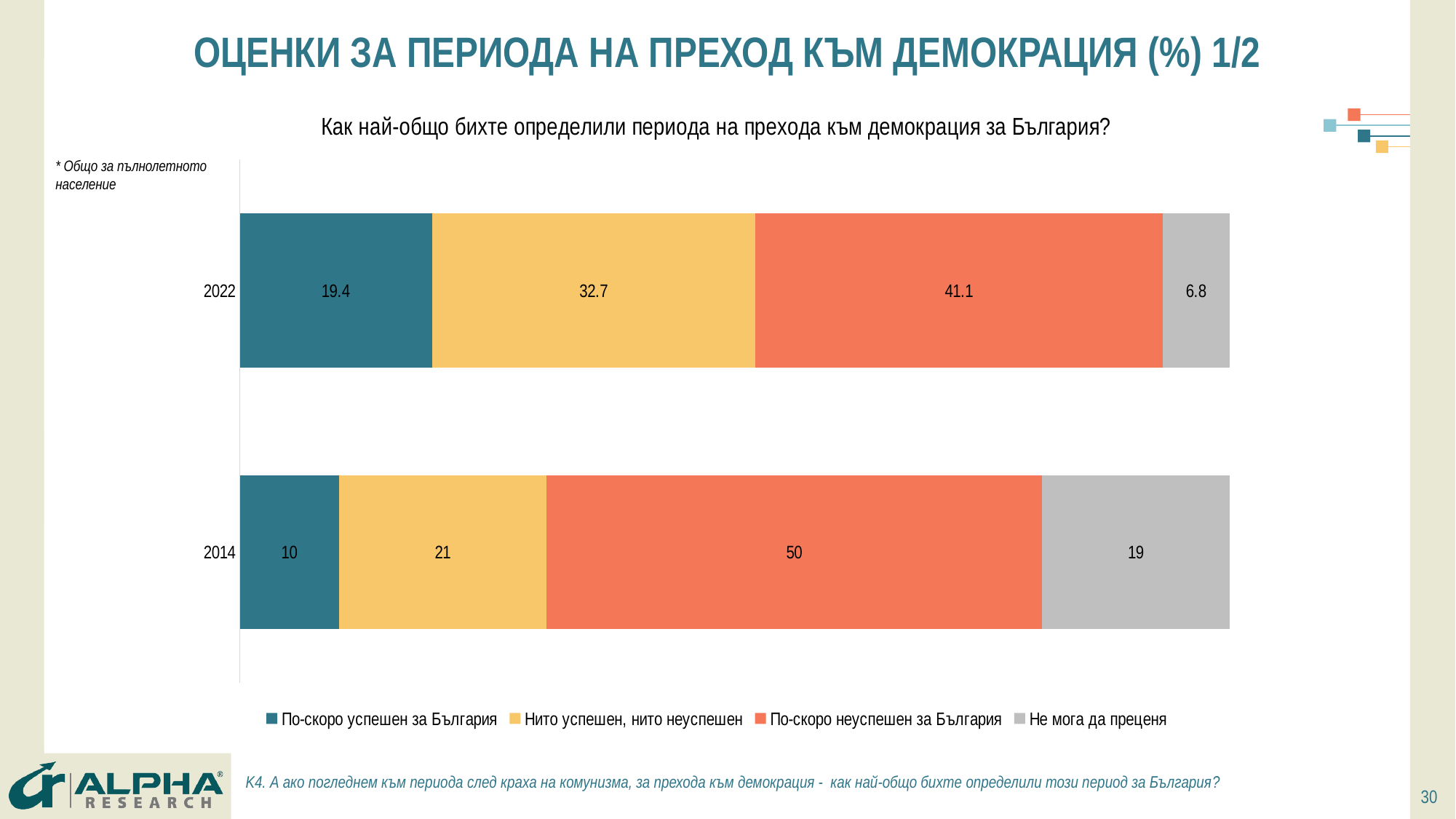
How many series does the legend list? 4 What is the total of the stacked bar for 2014? 100 Which series has the lowest value in 2014? По-скоро успешен за България Which year has the larger value for "Не мога да преценя", 2022 or 2014? 2014 What is the value for "Нито успешен, нито неуспешен" in 2014? 21 What kind of chart is shown on the slide? stacked bar chart What is the difference between the "По-скоро неуспешен за България" values for 2014 and 2022? 8.9 What is the value for "По-скоро неуспешен за България" in 2014? 50 How many categories (years) are shown on the chart? 2 What is the value for "Не мога да преценя" in 2022? 6.8 What is the value for "По-скоро успешен за България" in 2022? 19.4 Which series has the highest value in 2022? По-скоро неуспешен за България